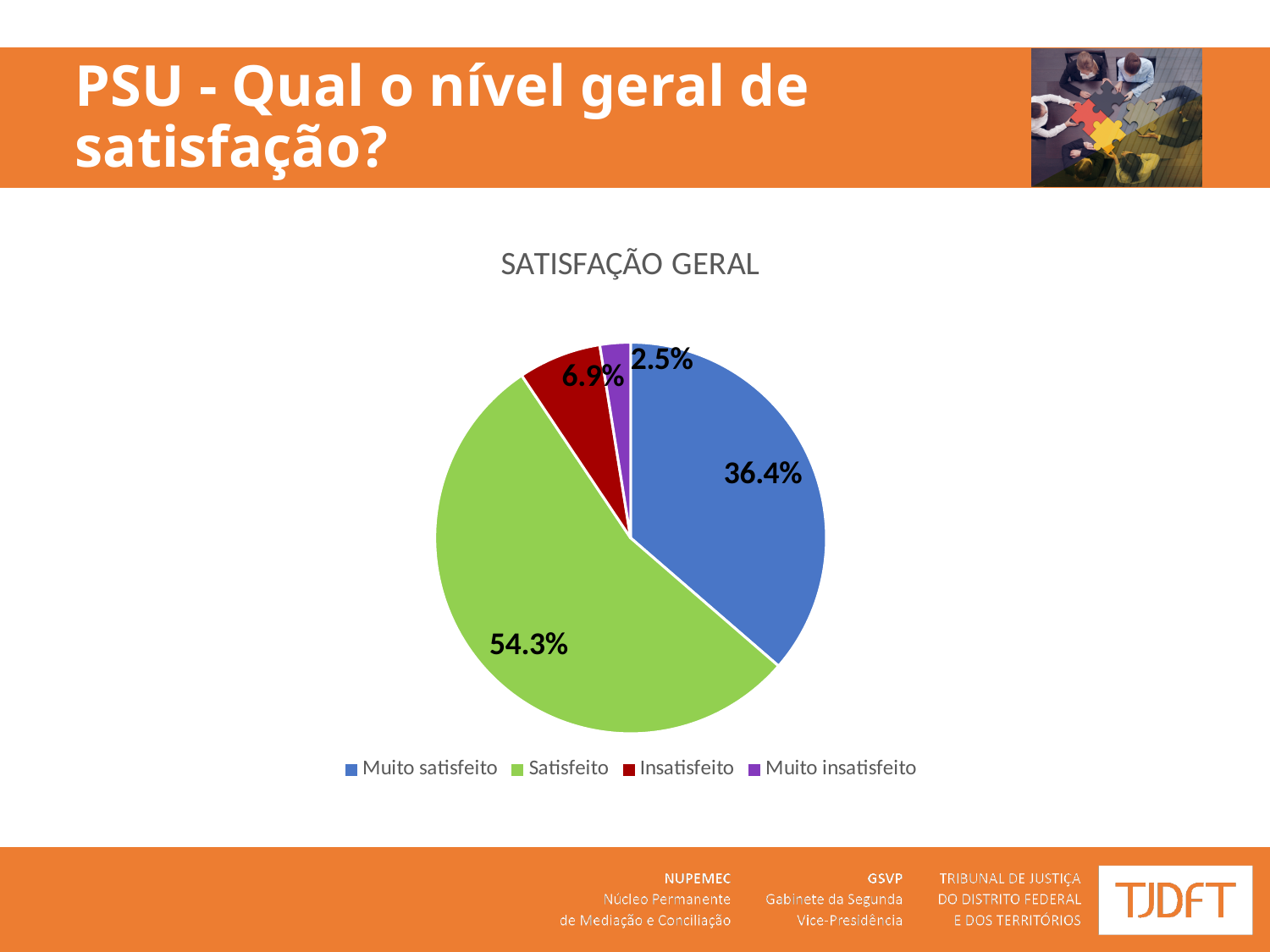
What percentage of the pie is labelled Insatisfeito? 6.9% How many categories does the legend list? 4 What is the difference in percentage points between Satisfeito and Muito satisfeito? 17.9 Which category has the largest slice of the pie? Satisfeito What colour is the Satisfeito slice? green What percentage of the pie is labelled Satisfeito? 54.3% What percentage of the pie is labelled Muito insatisfeito? 2.5% Which category has the smallest slice of the pie? Muito insatisfeito Which is larger, the Insatisfeito slice or the Muito insatisfeito slice? Insatisfeito What type of chart is shown on the slide? pie chart What is the title of the chart? SATISFAÇÃO GERAL What percentage of the pie is labelled Muito satisfeito? 36.4%